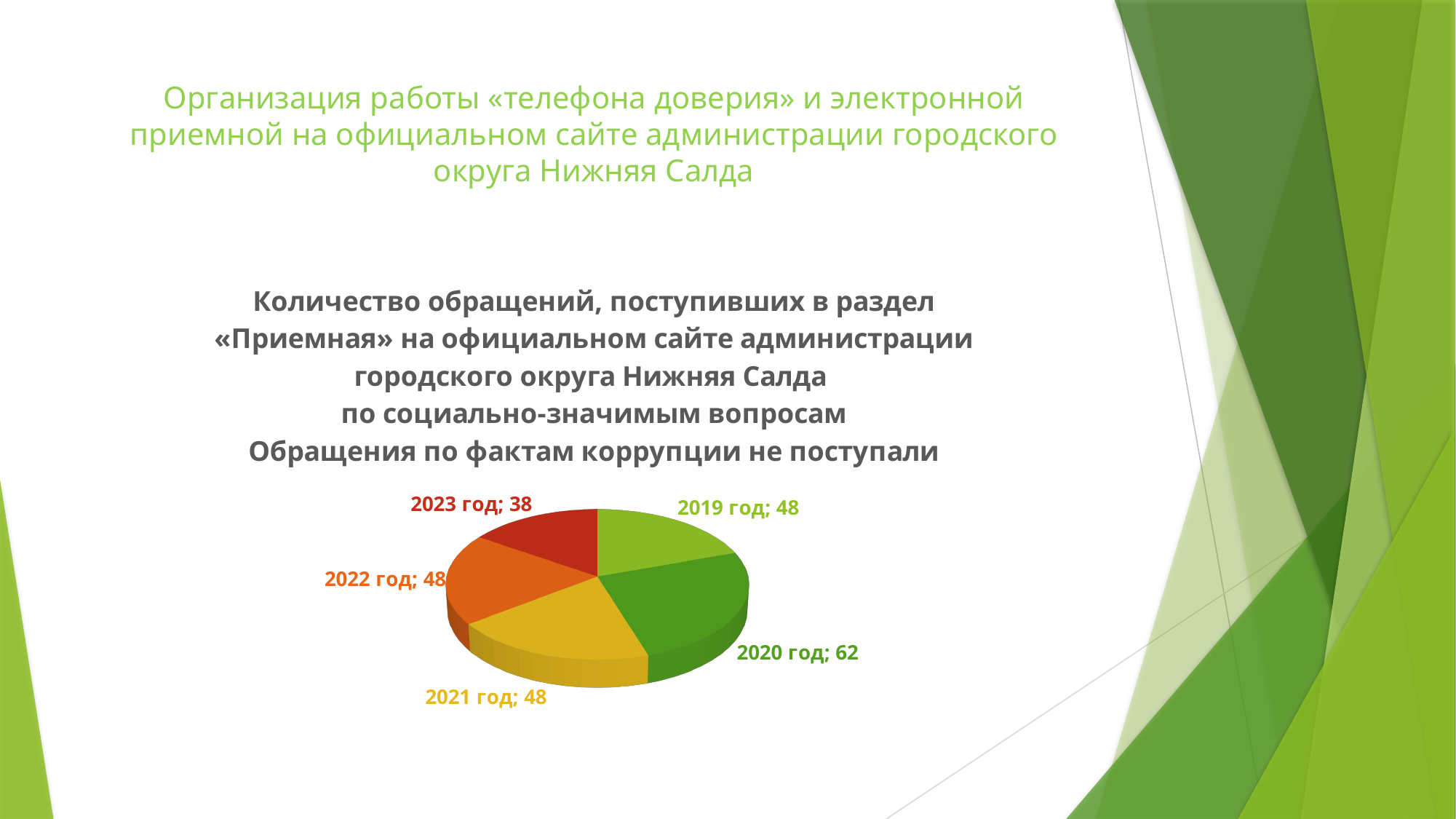
How many slices does the pie chart have? 5 What is the value for 2023 год in the pie chart? 38 What kind of chart is shown on the slide? pie chart Which is larger, the value for 2020 год or the value for 2021 год? 2020 год What is the total of all the values shown in the pie chart? 244 Which year has the largest slice in the pie chart? 2020 год What colour is the slice for 2023 год in the pie chart? red What is the difference between the values for 2020 год and 2023 год? 24 What is the value for 2019 год in the pie chart? 48 Which year has the smallest slice in the pie chart? 2023 год What is the value for 2020 год in the pie chart? 62 What is the difference between the values for 2022 год and 2023 год? 10